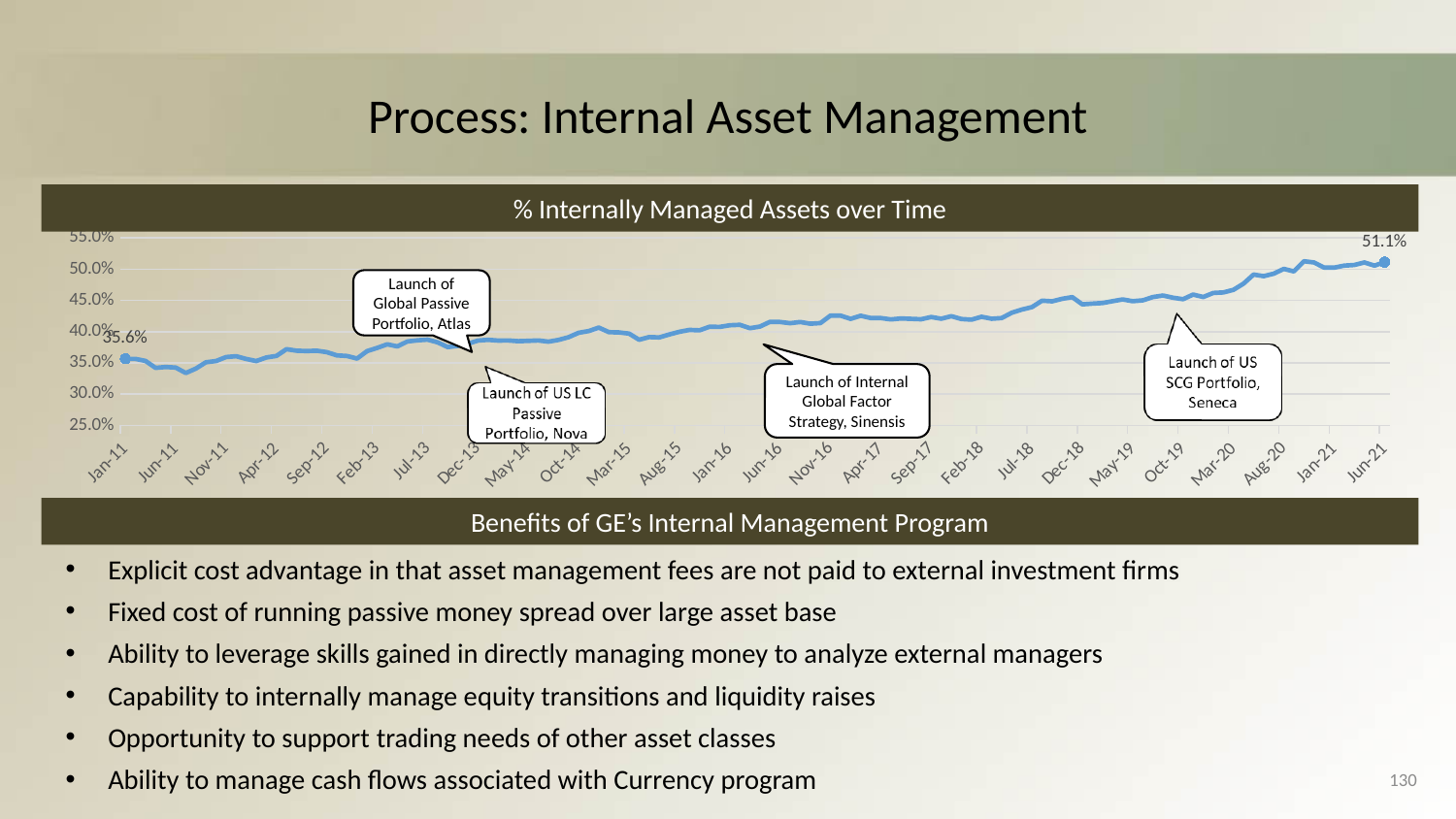
Overall, does the percentage of internally managed assets rise or fall from Jan-11 to Jun-21? Rise Which is larger, the value at Jan-11 or the value at Jun-21? Jun-21 What is the value of internally managed assets at Jun-21, the last point on the chart? 51.1% By how many percentage points did the share of internally managed assets change between Jan-11 (35.6%) and Jun-21 (51.1%)? 15.5 percentage points What is the value of internally managed assets at Jan-11, the first point on the chart? 35.6% Is the value for Jun-11 greater or less than 40.0%? less What is the highest tick value shown on the vertical axis? 55.0% Is the value for Jan-16 greater or less than 45.0%? less What is the title of the chart? % Internally Managed Assets over Time Is the value for Aug-20 greater or less than 45.0%? greater What kind of chart is shown on the slide? Line chart